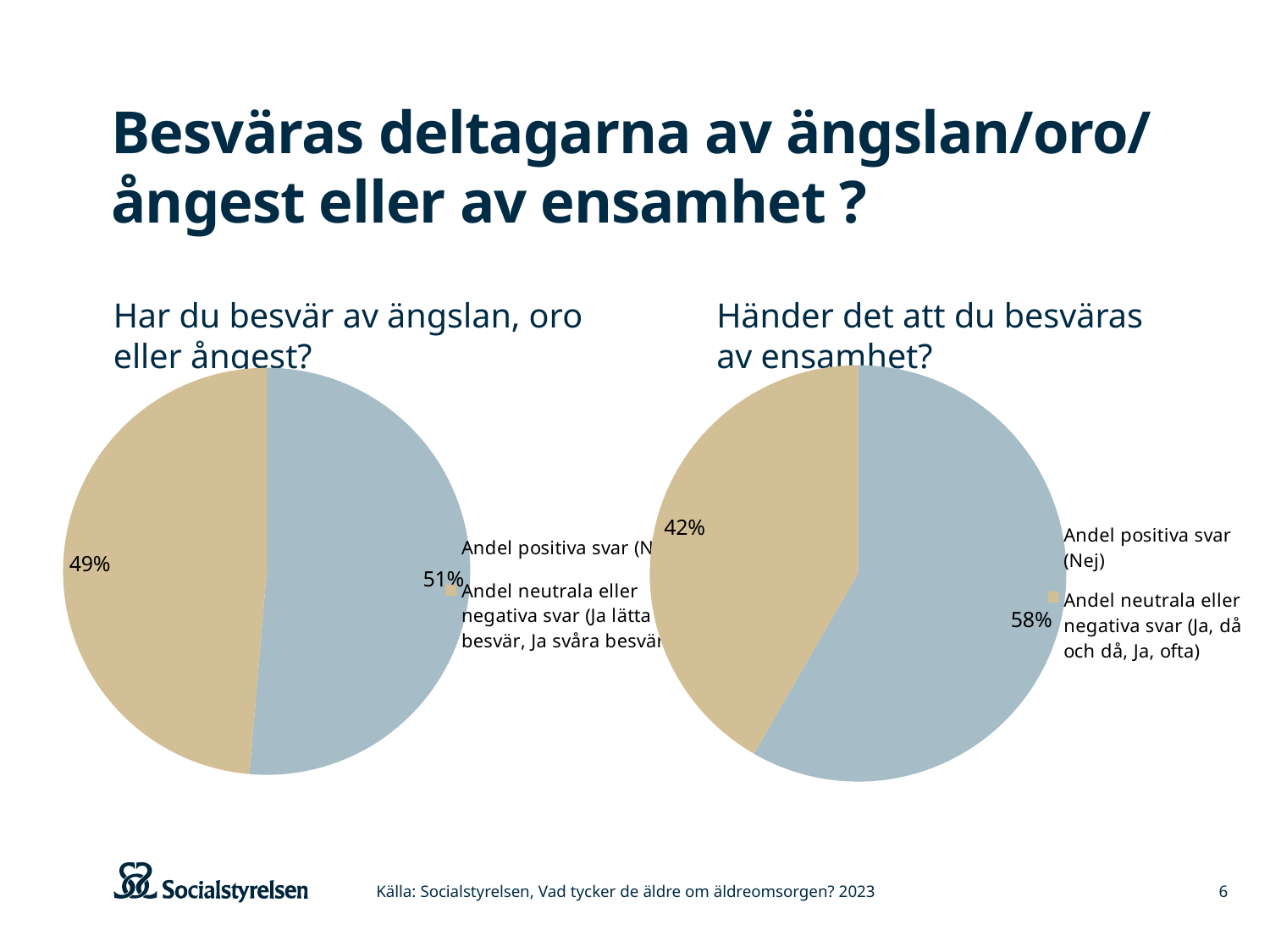
How many entries does the legend of the right chart "Händer det att du besväras av ensamhet?" list? 2 What type of chart is used on this slide? Pie chart In the right chart "Händer det att du besväras av ensamhet?", which slice is the largest? Andel positiva svar (Nej) How many slices does the right chart "Händer det att du besväras av ensamhet?" have? 2 In the left chart "Har du besvär av ängslan, oro eller ångest?", what share of answers are neutral or negative? 49% In the left chart "Har du besvär av ängslan, oro eller ångest?", what is the difference in percentage points between the positive and the neutral/negative share? 2 percentage points In the right chart "Händer det att du besväras av ensamhet?", which slice is the smallest? Andel neutrala eller negativa svar (Ja, då och då, Ja, ofta) In the right chart "Händer det att du besväras av ensamhet?", what share of answers are neutral or negative (Ja, då och då, Ja, ofta)? 42% In the right chart "Händer det att du besväras av ensamhet?", what share of answers are positive (Nej)? 58% In the right chart "Händer det att du besväras av ensamhet?", what is the difference in percentage points between the positive and the neutral/negative share? 16 percentage points Is the share of positive answers (Nej) larger in the left chart or in the right chart? The right chart In the left chart "Har du besvär av ängslan, oro eller ångest?", what share of answers are positive (Nej)? 51%